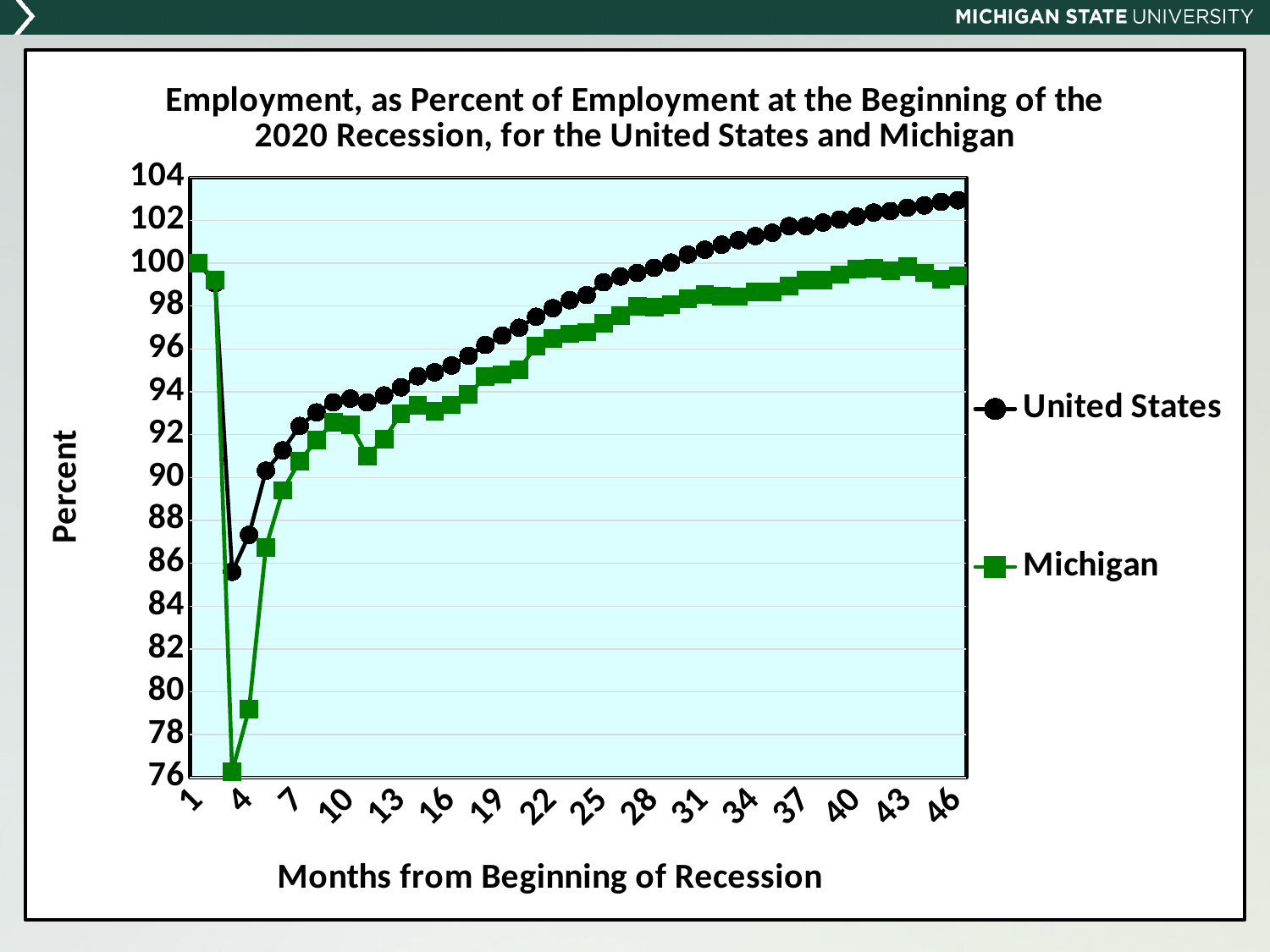
Which two series are shown in the legend? United States and Michigan What is the title of the vertical axis? Percent Is the lowest value for the United States greater or less than 88? less Is the value for the United States at month 46 greater or less than 102? greater Is the lowest value for Michigan greater or less than 78? less At month 46, which series has the higher value, United States or Michigan? United States What kind of chart is shown on the slide? line chart How many series does the legend list? 2 At which month does the United States series reach its lowest value? 3 After month 3, do the values for the United States series generally rise or fall as the months increase? rise At which month does the Michigan series reach its lowest value? 3